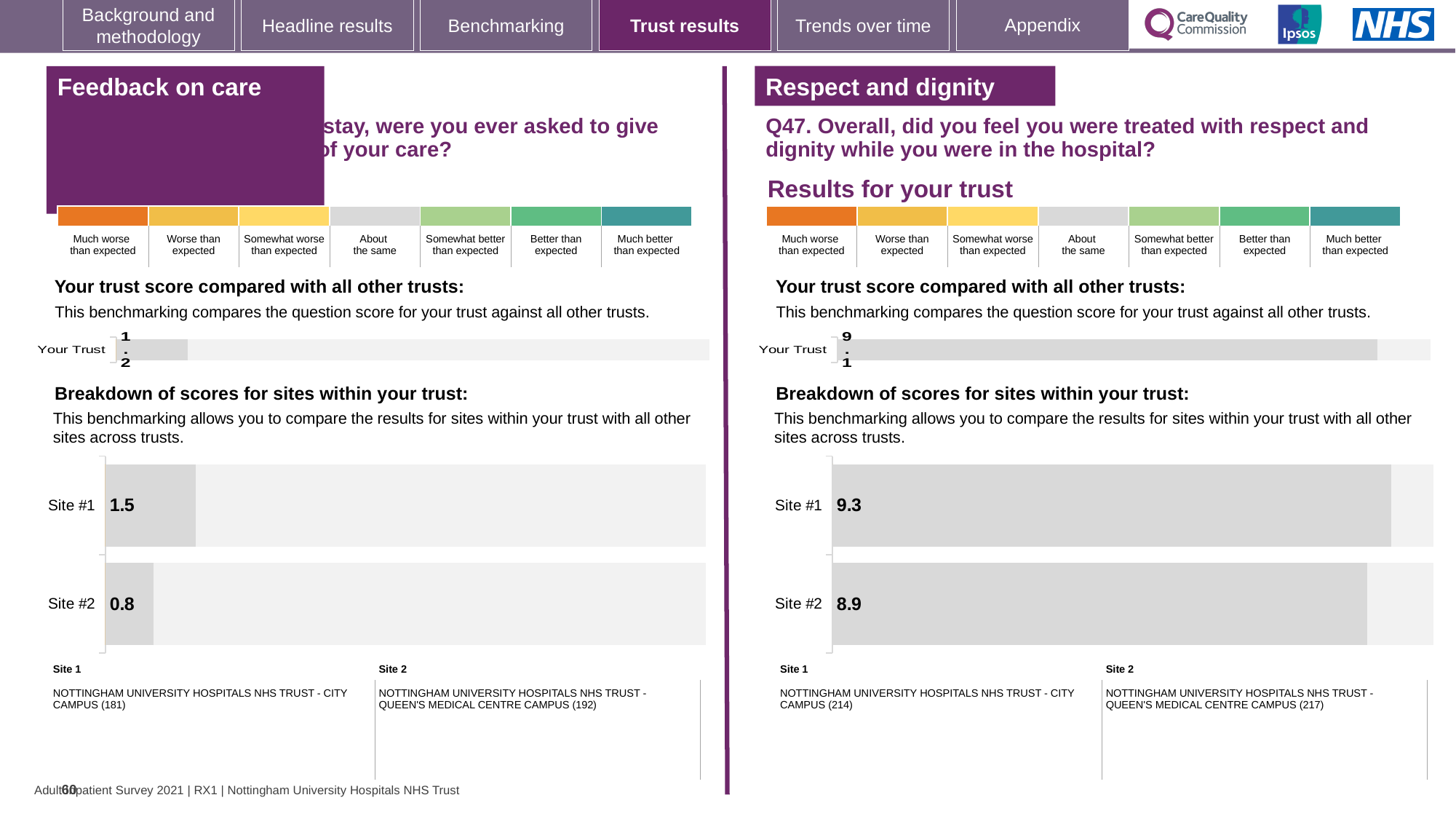
On the 'Respect and dignity' site breakdown chart, what is the score for Site #2? 8.9 On the 'Respect and dignity' site breakdown chart, which site has the lower score? Site #2 On the 'Feedback on care' site breakdown chart, what is the score for Site #1? 1.5 On the 'Respect and dignity' trust score chart, what is the value shown for Your Trust? 9.1 On the 'Feedback on care' site breakdown chart, what is the score for Site #2? 0.8 On the 'Respect and dignity' site breakdown chart, what is the difference between the Site #1 and Site #2 scores? 0.4 On the 'Feedback on care' trust score chart, what is the value shown for Your Trust? 1.2 What type of chart is used for the site breakdown on the 'Feedback on care' side of the slide? Bar chart On the 'Feedback on care' site breakdown chart, which site has the higher score? Site #1 On the 'Feedback on care' site breakdown chart, what is the difference between the Site #1 and Site #2 scores? 0.7 On the 'Respect and dignity' site breakdown chart, what is the score for Site #1? 9.3 How many sites are shown on the 'Respect and dignity' site breakdown chart? 2